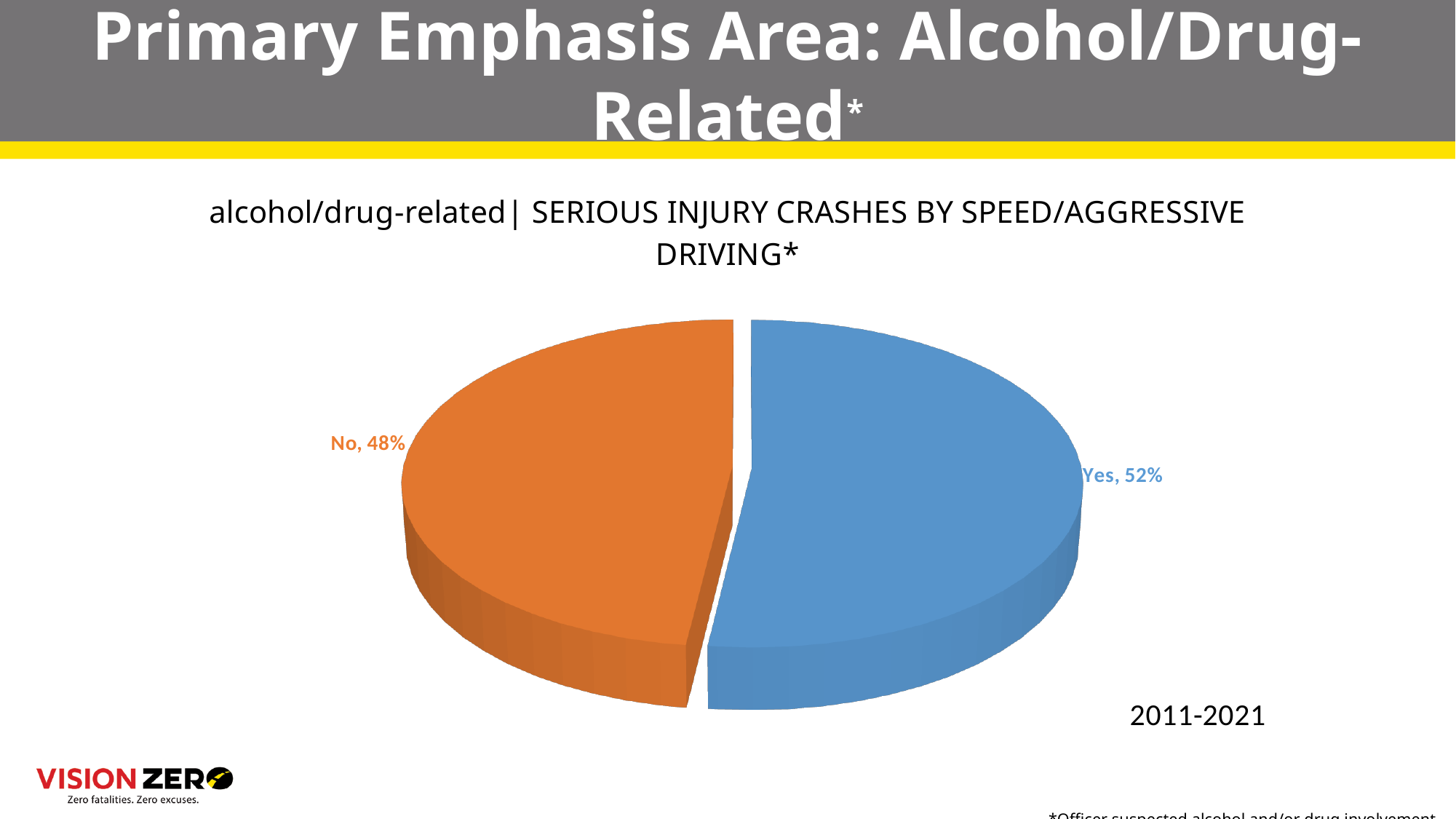
What share of alcohol/drug-related serious injury crashes involved speed/aggressive driving (Yes)? 52% What is the difference in percentage points between the Yes and No slices? 4 percentage points What share of alcohol/drug-related serious injury crashes did not involve speed/aggressive driving (No)? 48% What time period does the chart cover? 2011-2021 What kind of chart is shown on the slide? Pie chart How many slices does the pie chart have? 2 What colour is the Yes slice? Blue Which slice of the pie is larger, Yes or No? Yes Which category has the smallest share of the pie? No Is the share for Yes greater or less than 50%? greater Which category has the largest share of the pie? Yes